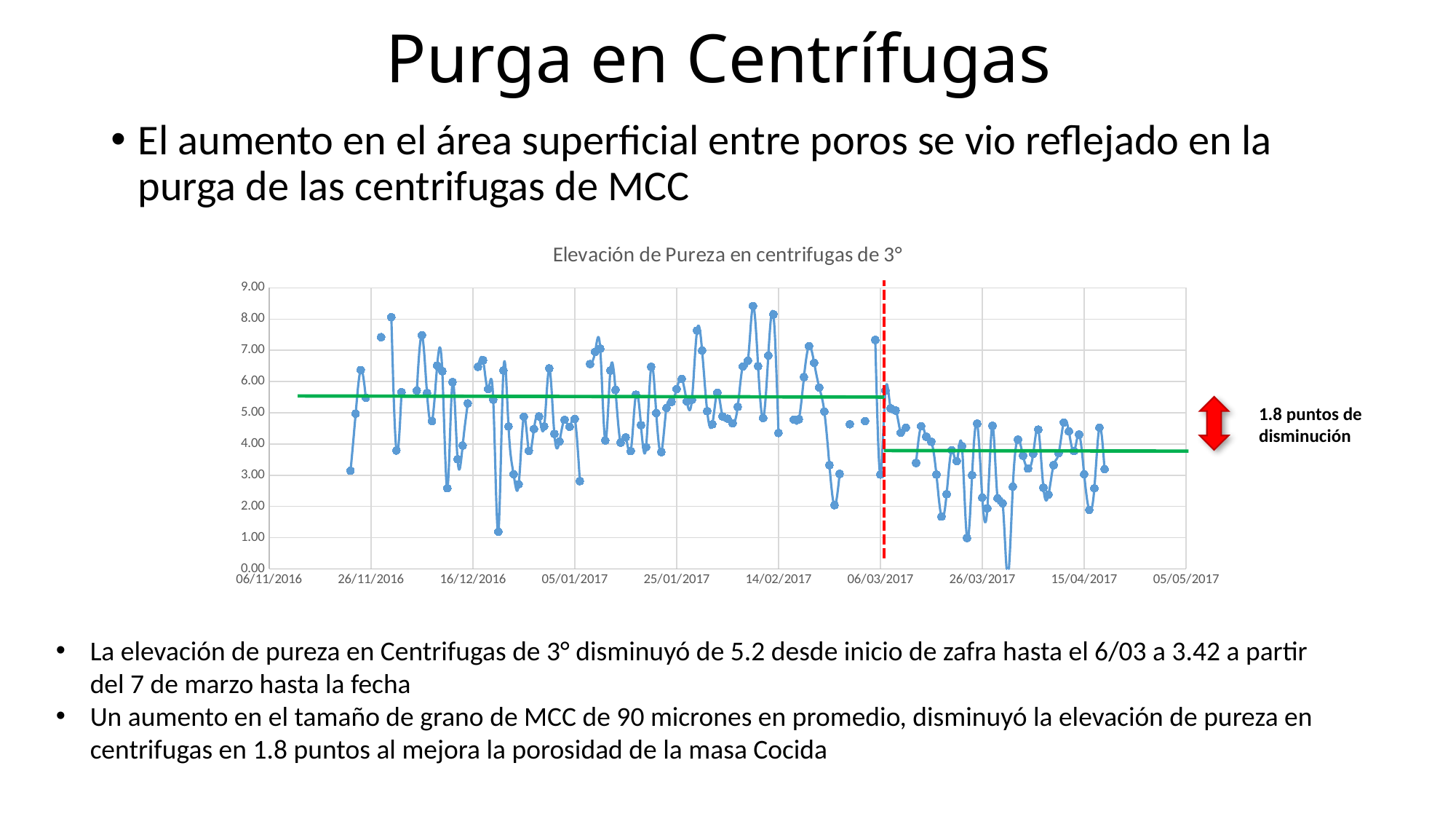
Is the lowest plotted point on the chart greater or less than 1.00? less What is the last date label on the x axis of the chart? 05/05/2017 What is the first date label on the x axis of the chart? 06/11/2016 Is the green horizontal line to the left of the red dashed line greater or less than 5.00? greater What kind of chart is shown on the slide? Line chart What is the maximum value shown on the chart's vertical axis? 9.00 Is the highest plotted point on the chart greater or less than 8.00? greater How many date labels are shown along the x axis of the chart? 10 What is the title of the chart? Elevación de Pureza en centrifugas de 3° Which green horizontal line is higher: the one before 06/03/2017 or the one after it? The one before 06/03/2017 Overall, do the plotted values rise or fall after the red dashed line at 06/03/2017? Fall